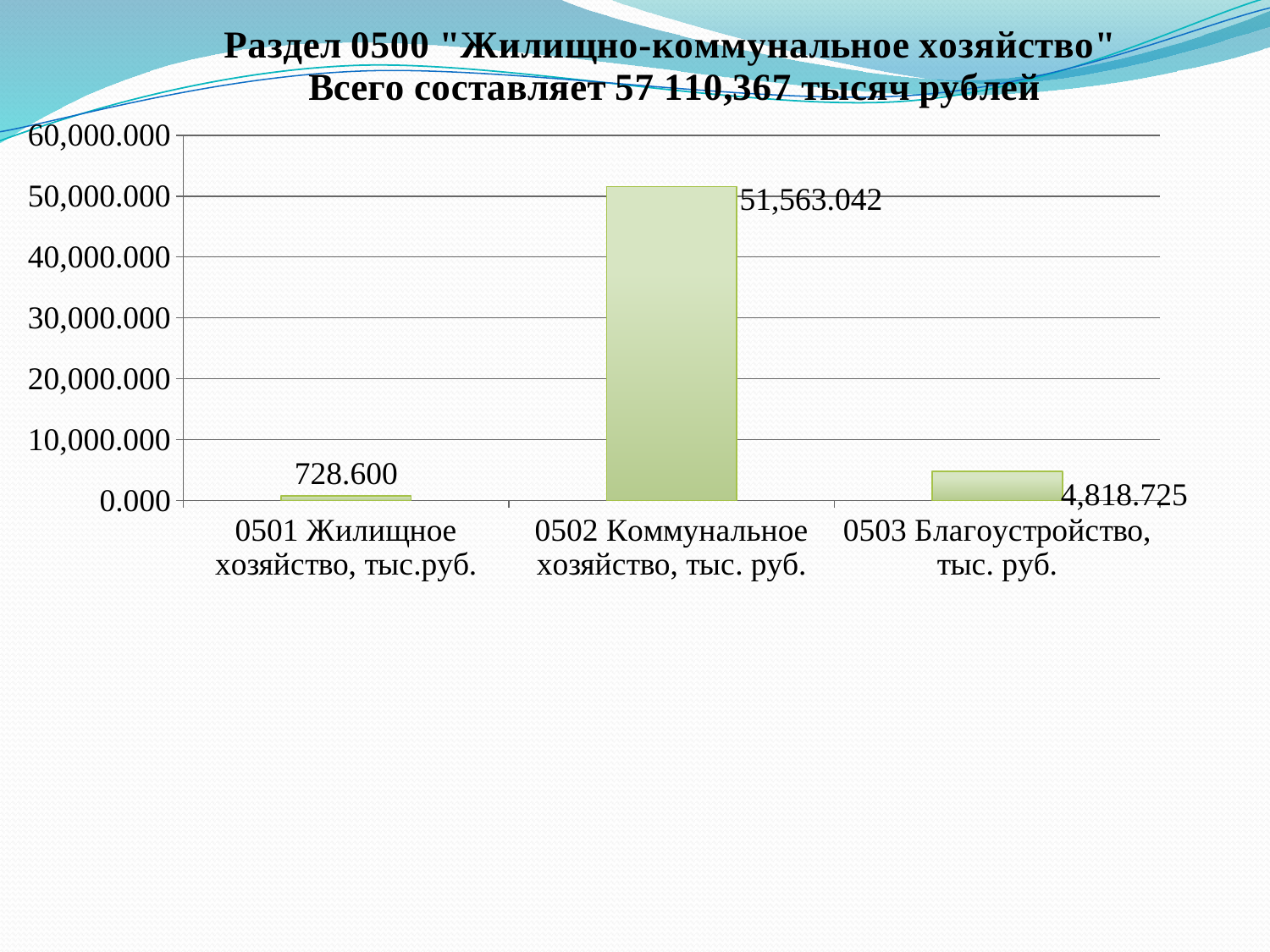
According to the slide title, what is the total for Раздел 0500 "Жилищно-коммунальное хозяйство"? 57 110,367 тысяч рублей What is the value for 0503 Благоустройство? 4,818.725 What is the value for 0502 Коммунальное хозяйство? 51,563.042 How many categories are shown in the chart? 3 What is the difference between the values for 0503 Благоустройство and 0501 Жилищное хозяйство? 4,090.125 Which category has the highest value? 0502 Коммунальное хозяйство What is the difference between the values for 0502 Коммунальное хозяйство and 0503 Благоустройство? 46,744.317 What kind of chart is shown on the slide? bar chart Which is larger, the value for 0503 Благоустройство or the value for 0501 Жилищное хозяйство? 0503 Благоустройство Is the value for 0502 Коммунальное хозяйство greater or less than 50,000.000? greater Which category has the lowest value? 0501 Жилищное хозяйство What is the value for 0501 Жилищное хозяйство? 728.600